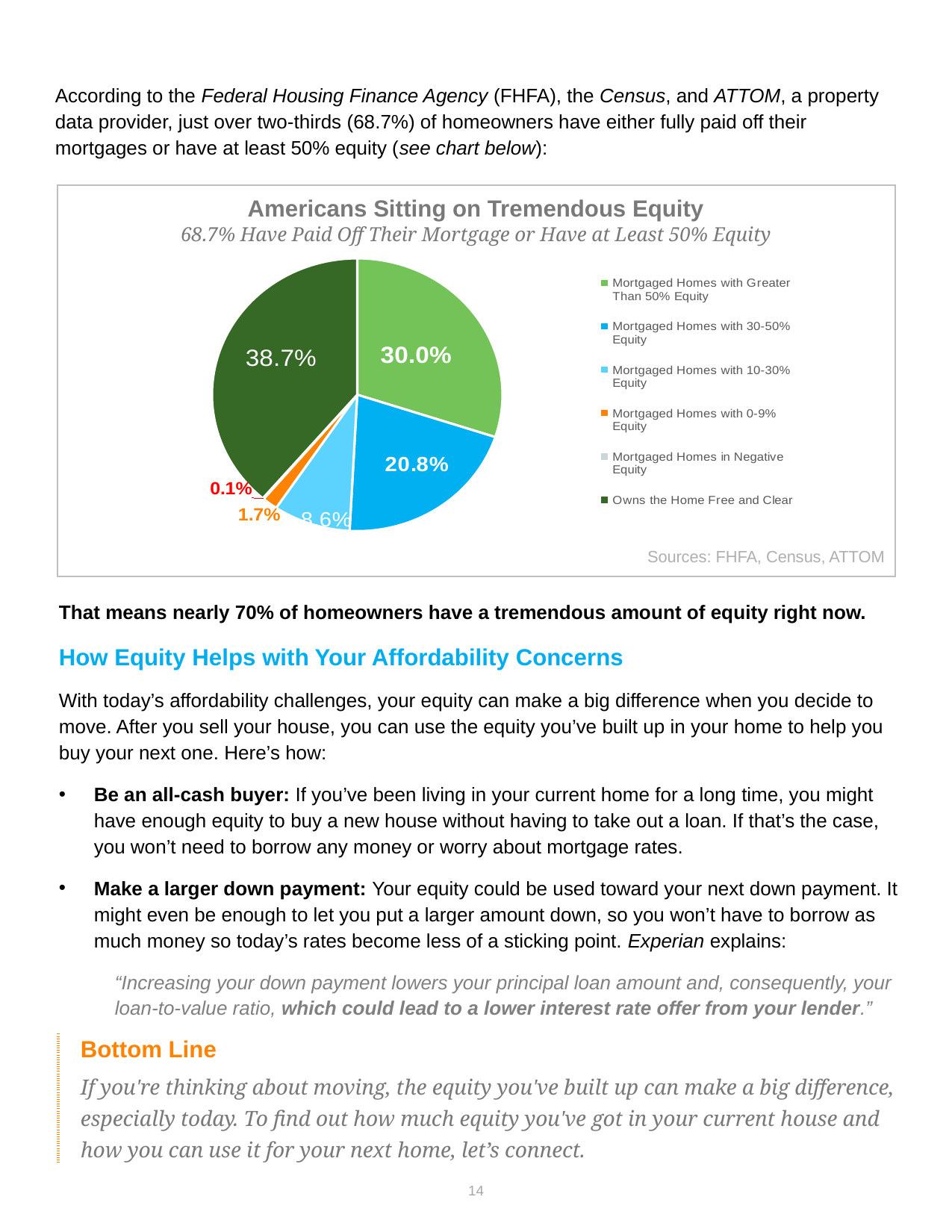
Which category has the smallest slice of the pie? Mortgaged Homes in Negative Equity What is the value shown for Mortgaged Homes with Greater Than 50% Equity? 30.0% What is the difference between the Owns the Home Free and Clear slice and the Mortgaged Homes with Greater Than 50% Equity slice? 8.7% What is the value shown for Mortgaged Homes with 30-50% Equity? 20.8% What is the value shown for Mortgaged Homes with 0-9% Equity? 1.7% What type of chart is shown on the slide? Pie chart What share of the pie is labeled for Owns the Home Free and Clear? 38.7% What is the title of the chart? Americans Sitting on Tremendous Equity What is the value shown for Mortgaged Homes in Negative Equity? 0.1% How many categories does the legend list? 6 Which is larger: the slice for Mortgaged Homes with 30-50% Equity or the slice for Mortgaged Homes with 10-30% Equity? Mortgaged Homes with 30-50% Equity Which category has the largest slice of the pie? Owns the Home Free and Clear